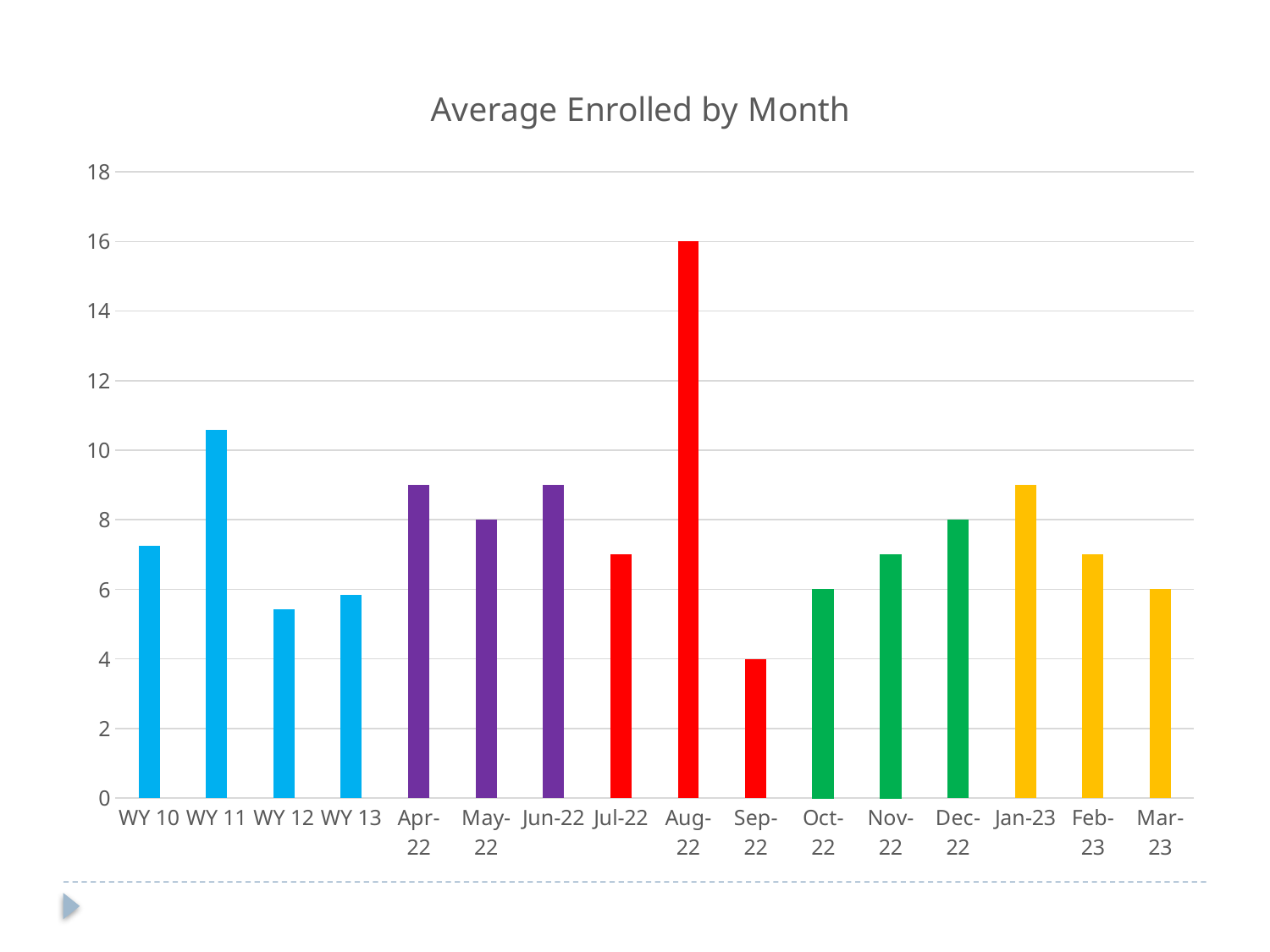
What is the difference between the values for Aug-22 and Sep-22? 12 Is the value for WY 11 greater or less than 10? greater How many categories are shown on the x axis? 16 What kind of chart is shown on the slide? bar chart Which is larger, the value for WY 11 or the value for WY 10? WY 11 Which category has the lowest value? Sep-22 What is the title of the chart? Average Enrolled by Month Do the values rise or fall from Jan-23 to Mar-23? fall What is the value for Aug-22? 16 What is the value for Sep-22? 4 What is the value for Dec-22? 8 Which category has the highest value? Aug-22